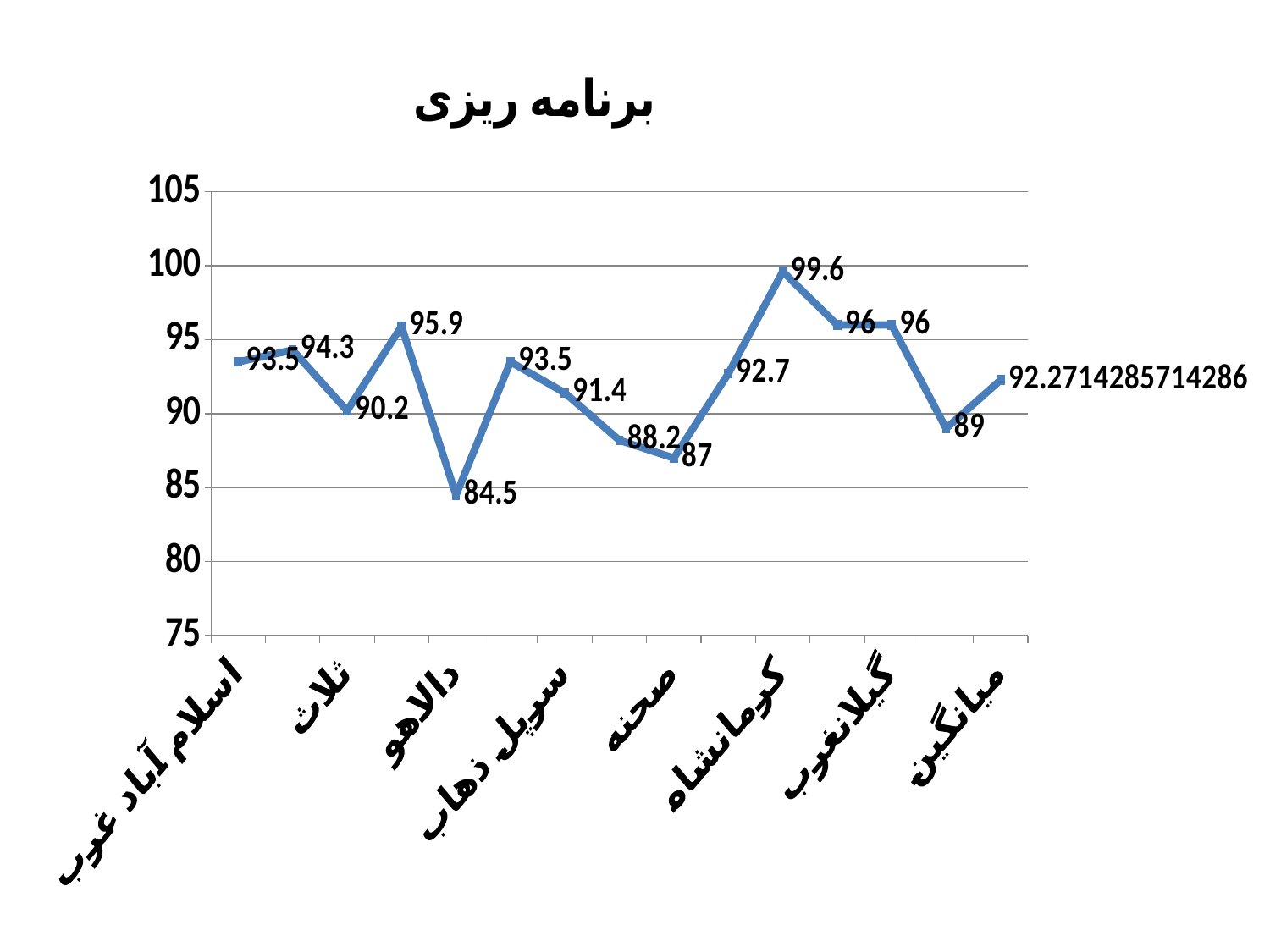
Which category has the lowest value? دالاهو What kind of chart is shown? line chart What is the difference between the values for کرمانشاه and دالاهو? 15.1 What is the value for کرمانشاه? 99.6 What is the title of the chart? برنامه ریزی How many data points are plotted on the line? 15 Which is larger, the value for گیلانغرب or the value for ثلاث? گیلانغرب What is the value for صحنه? 87 Is the value for سرپل ذهاب greater or less than 90? greater What is the value for میانگین? 92.2714285714286 What is the value for دالاهو? 84.5 Which category has the highest value? کرمانشاه